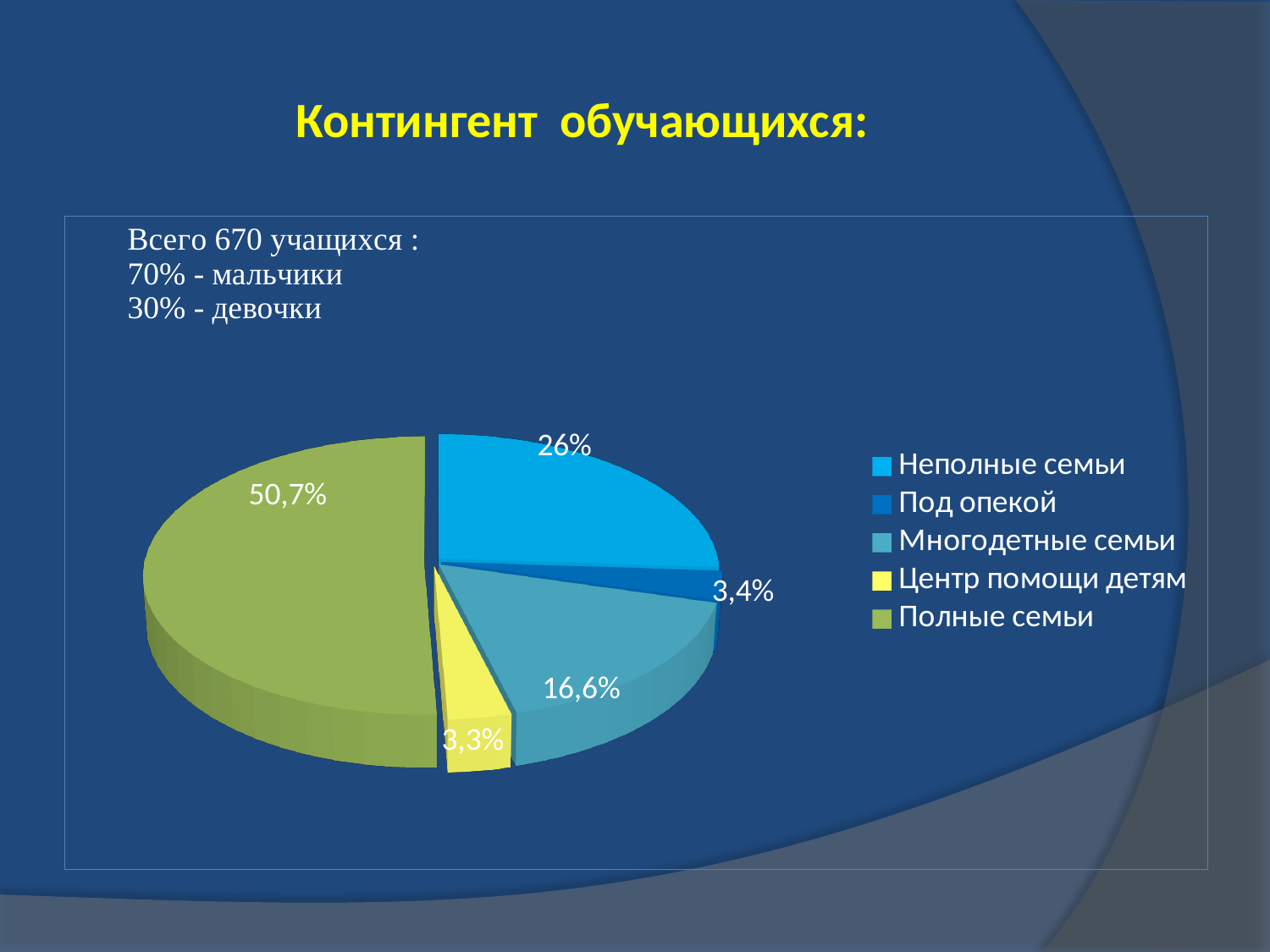
How many categories does the legend list? 5 What colour is the slice for Полные семьи? green What is the difference in percentage points between Полные семьи and Неполные семьи? 24,7 What share of the pie is labelled for Полные семьи? 50,7% What kind of chart is shown on the slide? pie chart Which category has the largest slice of the pie? Полные семьи What share of the pie is labelled for Многодетные семьи? 16,6% What is the title of the slide containing the chart? Контингент обучающихся: What share of the pie is labelled for Центр помощи детям? 3,3% What share of the pie is labelled for Под опекой? 3,4% Which slice is larger: Неполные семьи or Многодетные семьи? Неполные семьи What share of the pie is labelled for Неполные семьи? 26%